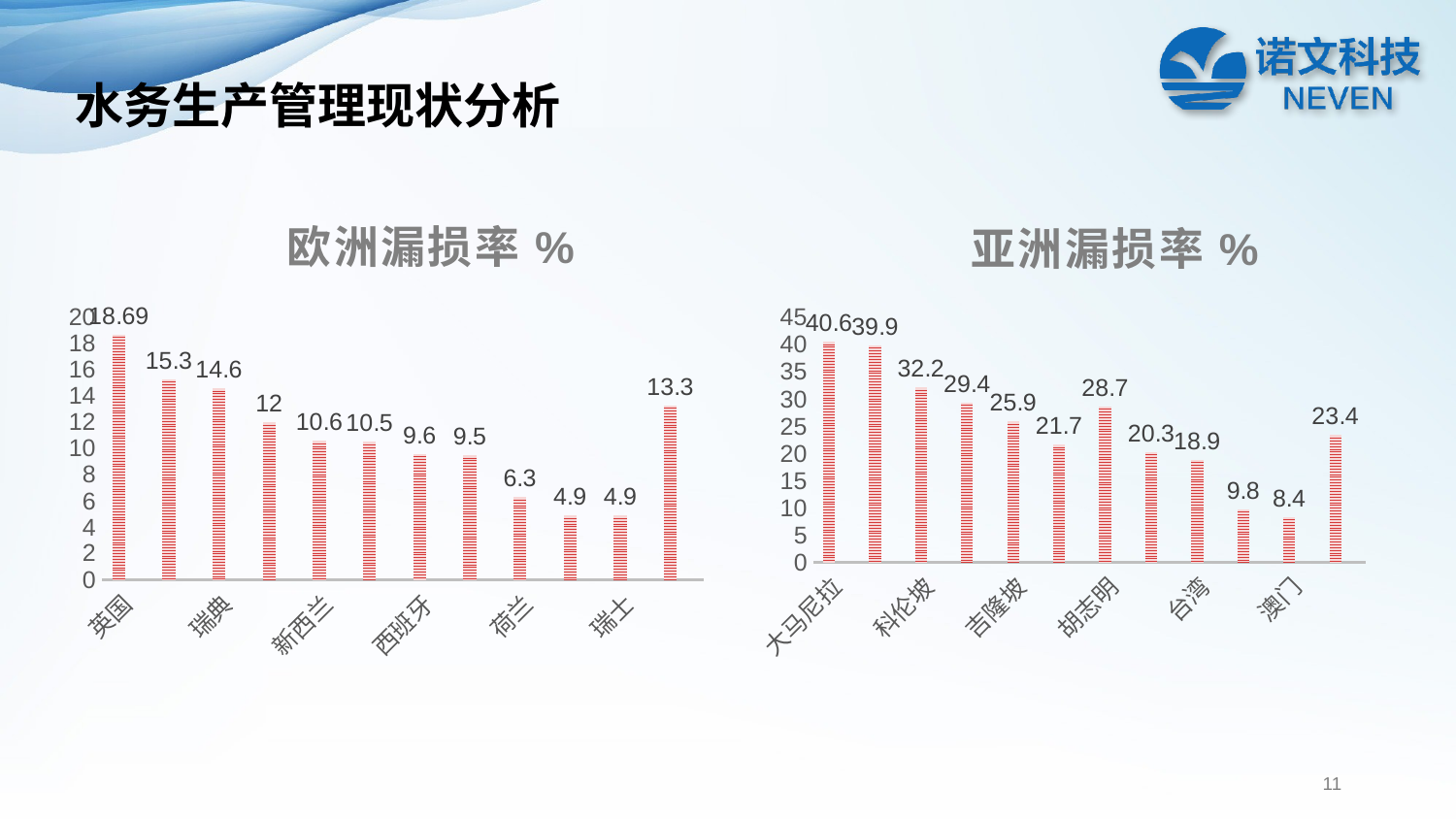
In the 欧洲漏损率 % chart, which labelled category has the highest value? 英国 In the 亚洲漏损率 % chart, what is the value for 胡志明? 28.7 In the 亚洲漏损率 % chart, which is larger, the value for 科伦坡 or the value for 胡志明? 科伦坡 What kind of chart is the 亚洲漏损率 % chart? bar chart In the 欧洲漏损率 % chart, what is the value for 荷兰? 6.3 In the 欧洲漏损率 % chart, what is the difference between the values for 瑞典 and 新西兰? 4 In the 亚洲漏损率 % chart, is the value for 台湾 greater or less than 20? less In the 亚洲漏损率 % chart, which labelled category has the lowest value? 澳门 In the 亚洲漏损率 % chart, what is the value for 大马尼拉? 40.6 What is the title of the chart on the right side of the slide? 亚洲漏损率 % How many bars are plotted in the 欧洲漏损率 % chart? 12 In the 欧洲漏损率 % chart, what is the value for 英国? 18.69